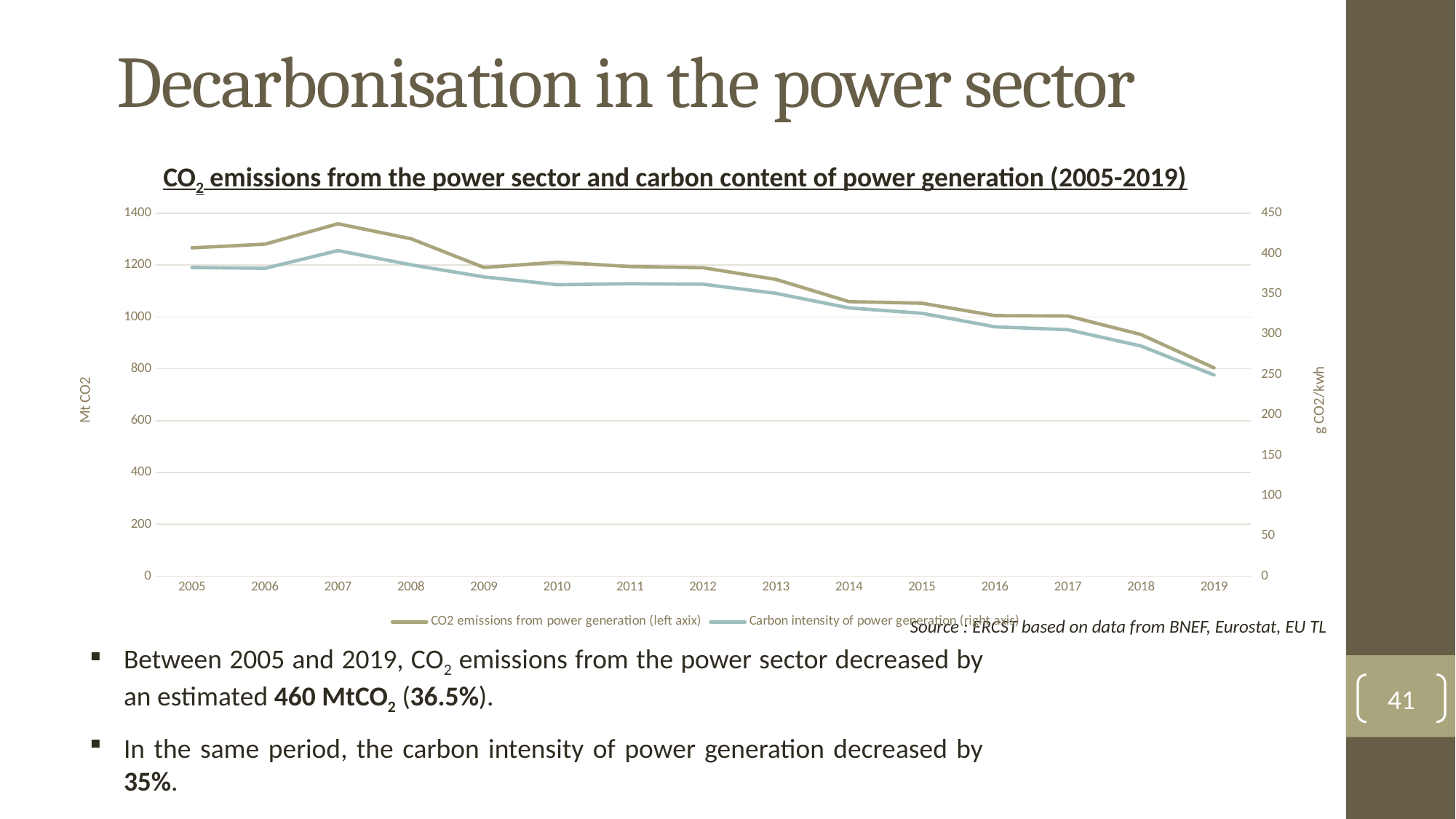
In which year are CO2 emissions from power generation lowest? 2019 What is the unit label on the right vertical axis of the chart? g CO2/kwh Do CO2 emissions from power generation rise or fall overall from 2005 to 2019? Fall In which year do CO2 emissions from power generation reach their highest value? 2007 What is the unit label on the left vertical axis of the chart? Mt CO2 What kind of chart is shown on the slide? Line chart How many series does the chart legend list? 2 Which year has higher CO2 emissions from power generation, 2007 or 2009? 2007 Is the value for CO2 emissions from power generation in 2007 greater or less than 1200? greater Is the value for carbon intensity of power generation in 2019 greater or less than 300 g CO2/kWh? less Is the value for CO2 emissions from power generation in 2019 greater or less than 1000? less How many years are plotted along the x axis of the chart? 15